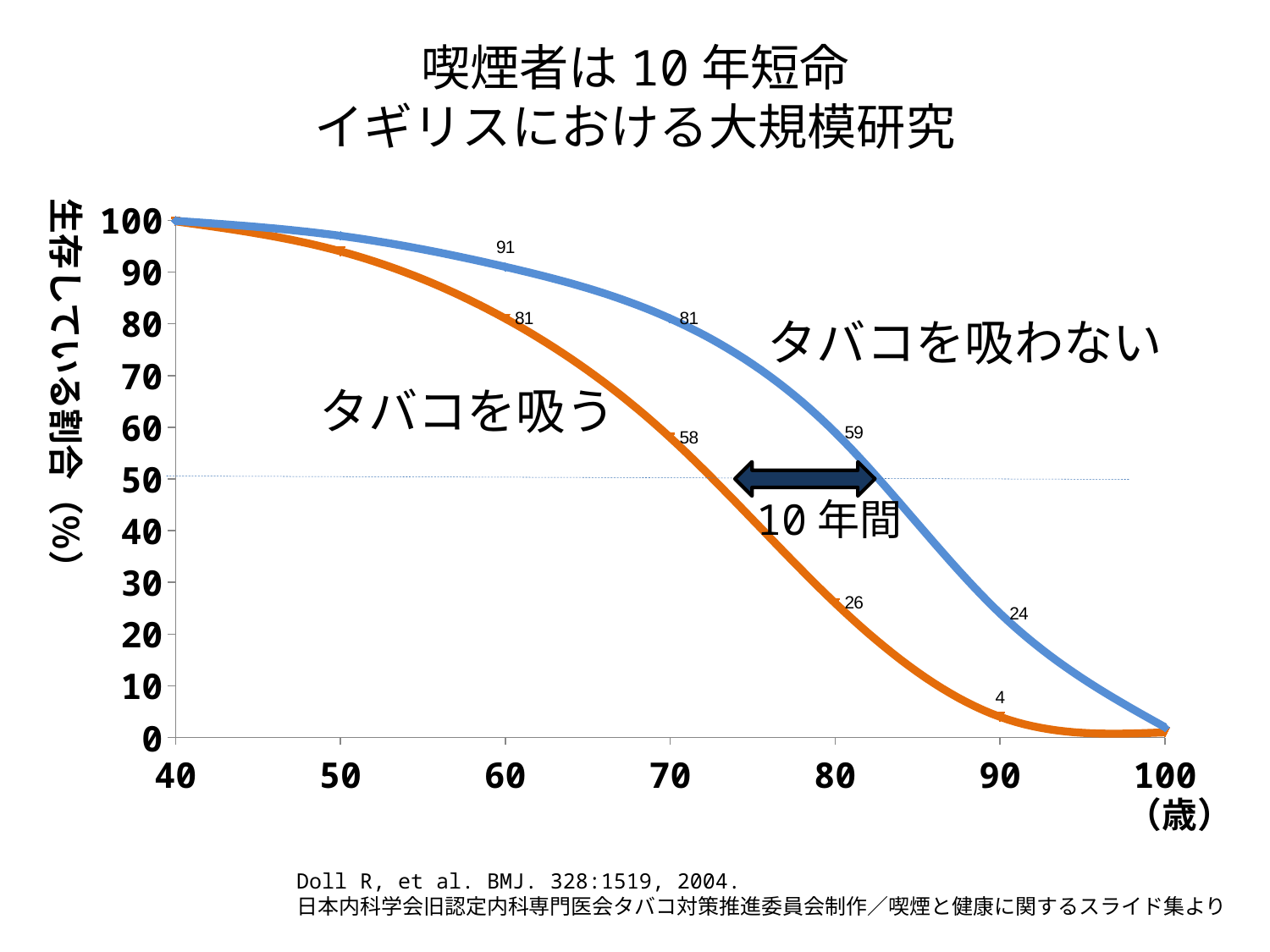
At age 80, what is the difference between the non-smoker value and the smoker value? 33 What is the survival percentage for タバコを吸う (smokers) at age 90? 4 At age 70, what is the difference between the non-smoker value (81) and the smoker value (58)? 23 What is the survival percentage for タバコを吸わない (non-smokers) at age 60? 91 At age 90, which line has the higher value, タバコを吸う or タバコを吸わない? タバコを吸わない What kind of chart is shown on the slide? Line chart What label is written next to the horizontal arrow at the 50% line? 10年間 What is the survival percentage for タバコを吸わない (non-smokers) at age 80? 59 Is the value for タバコを吸う (smokers) at age 50 greater or less than 90? greater How many lines are plotted on the chart? 2 Do the values rise or fall as age increases along the x axis? Fall What is the survival percentage for タバコを吸う (smokers) at age 70? 58